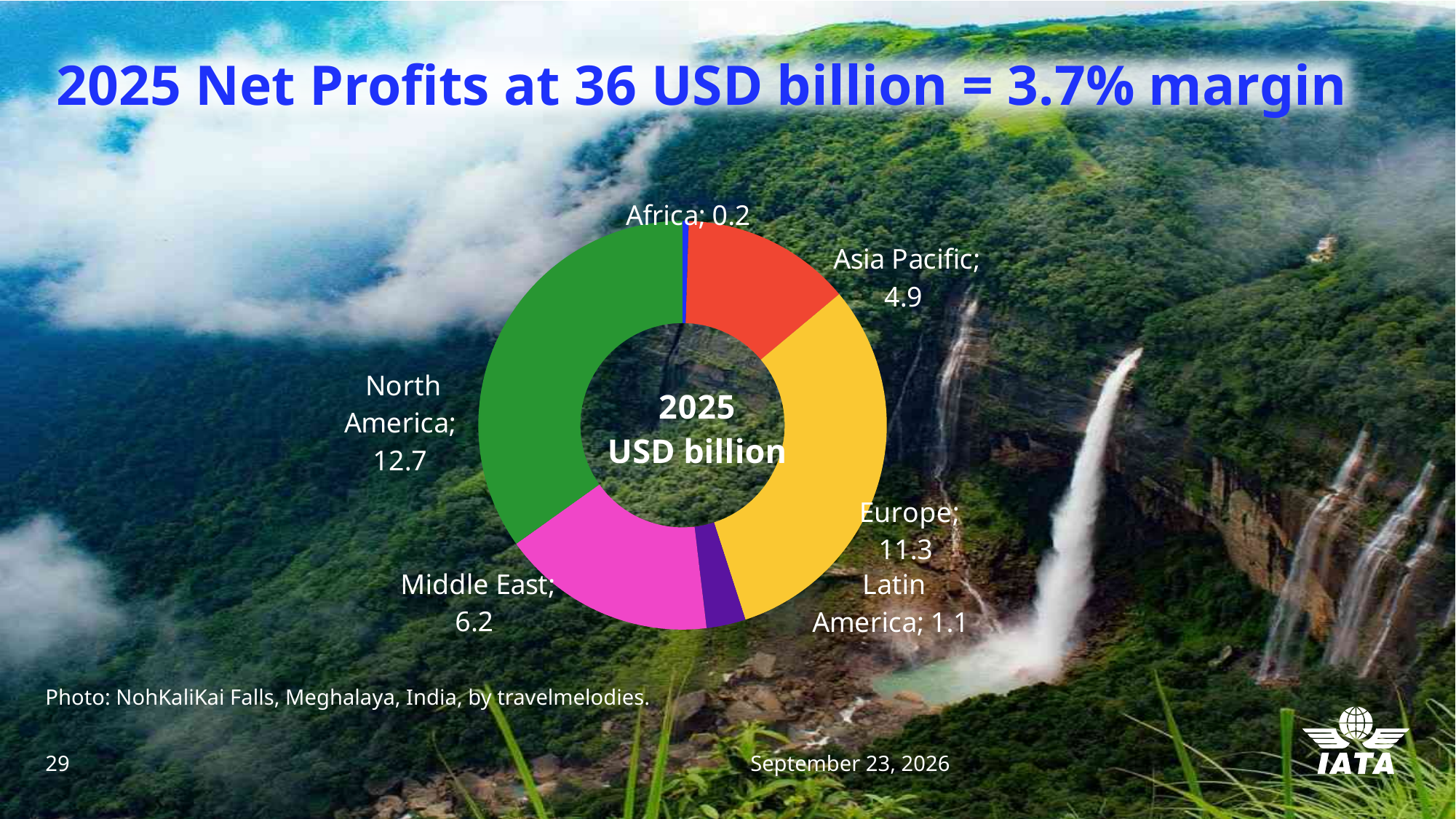
Which region has the largest slice? North America What is the value for North America? 12.7 What is the value for Asia Pacific? 4.9 What text is written in the centre of the donut chart? 2025 USD billion Which is larger, the value for Europe or the value for Middle East? Europe What is the difference between the values for North America and Europe? 1.4 What is the difference between the values for Middle East and Latin America? 5.1 What is the value for Africa? 0.2 Which region has the smallest slice? Africa What is the value for Europe? 11.3 What type of chart is shown on the slide? Pie (donut) chart How many regions are shown in the chart? 6